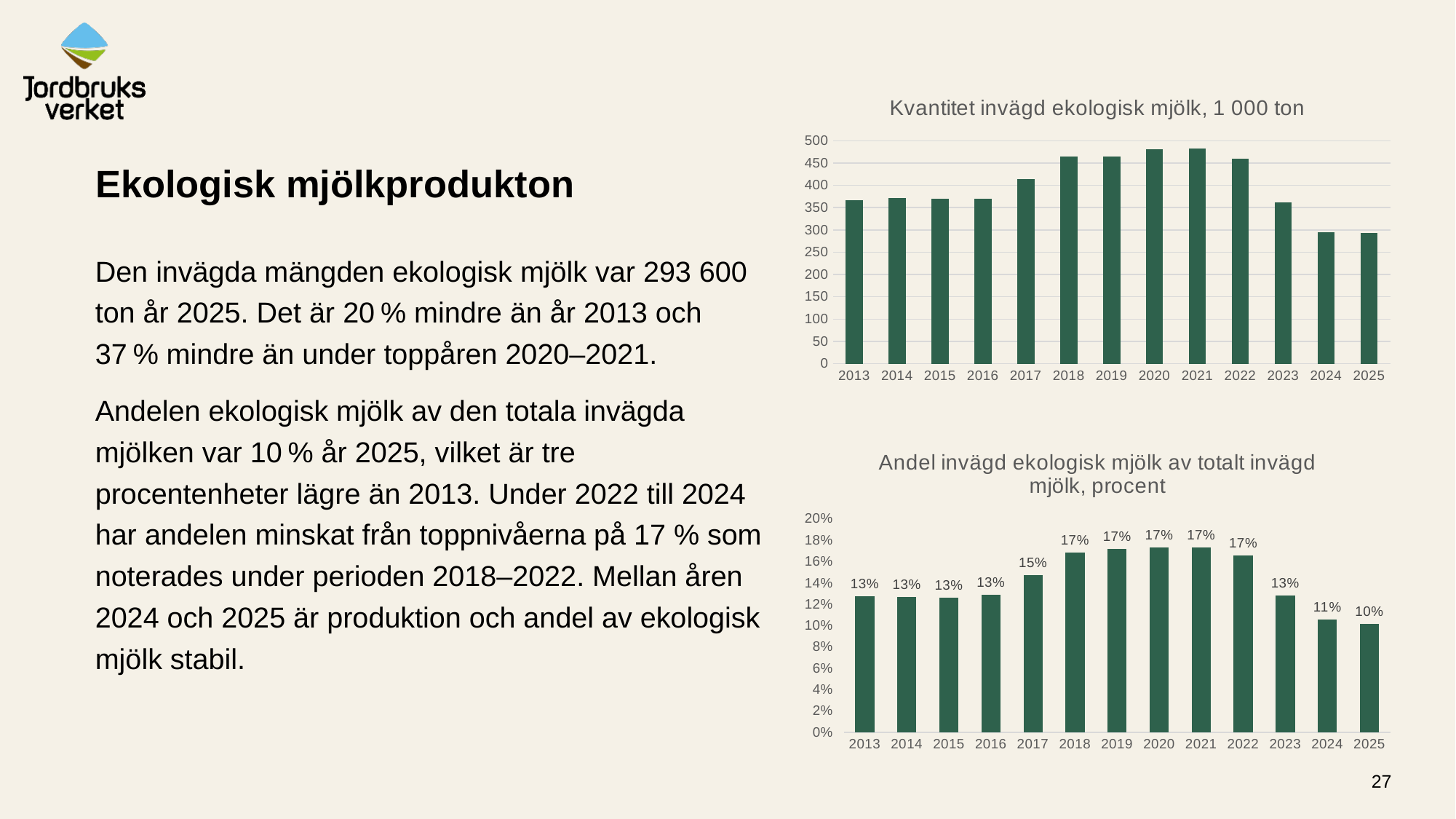
In the top chart 'Kvantitet invägd ekologisk mjölk, 1 000 ton', is the value for 2013 greater or less than 350? greater In the bottom chart 'Andel invägd ekologisk mjölk av totalt invägd mjölk, procent', which year has the lowest value? 2025 In the bottom chart 'Andel invägd ekologisk mjölk av totalt invägd mjölk, procent', what is the value for 2017? 15% In the top chart 'Kvantitet invägd ekologisk mjölk, 1 000 ton', is the value for 2025 greater or less than 300? less In the bottom chart 'Andel invägd ekologisk mjölk av totalt invägd mjölk, procent', which is larger, the value for 2017 or the value for 2023? 2017 In the top chart 'Kvantitet invägd ekologisk mjölk, 1 000 ton', do the values rise or fall from 2021 to 2025? fall In the top chart 'Kvantitet invägd ekologisk mjölk, 1 000 ton', is the value for 2018 greater or less than 450? greater In the top chart 'Kvantitet invägd ekologisk mjölk, 1 000 ton', how many years are shown on the x axis? 13 What kind of chart is the top chart 'Kvantitet invägd ekologisk mjölk, 1 000 ton'? bar chart In the bottom chart 'Andel invägd ekologisk mjölk av totalt invägd mjölk, procent', what is the value for 2024? 11% What is the title of the bottom chart on the slide? Andel invägd ekologisk mjölk av totalt invägd mjölk, procent In the bottom chart 'Andel invägd ekologisk mjölk av totalt invägd mjölk, procent', what is the difference between the values for 2018 and 2025? 7 percentage points